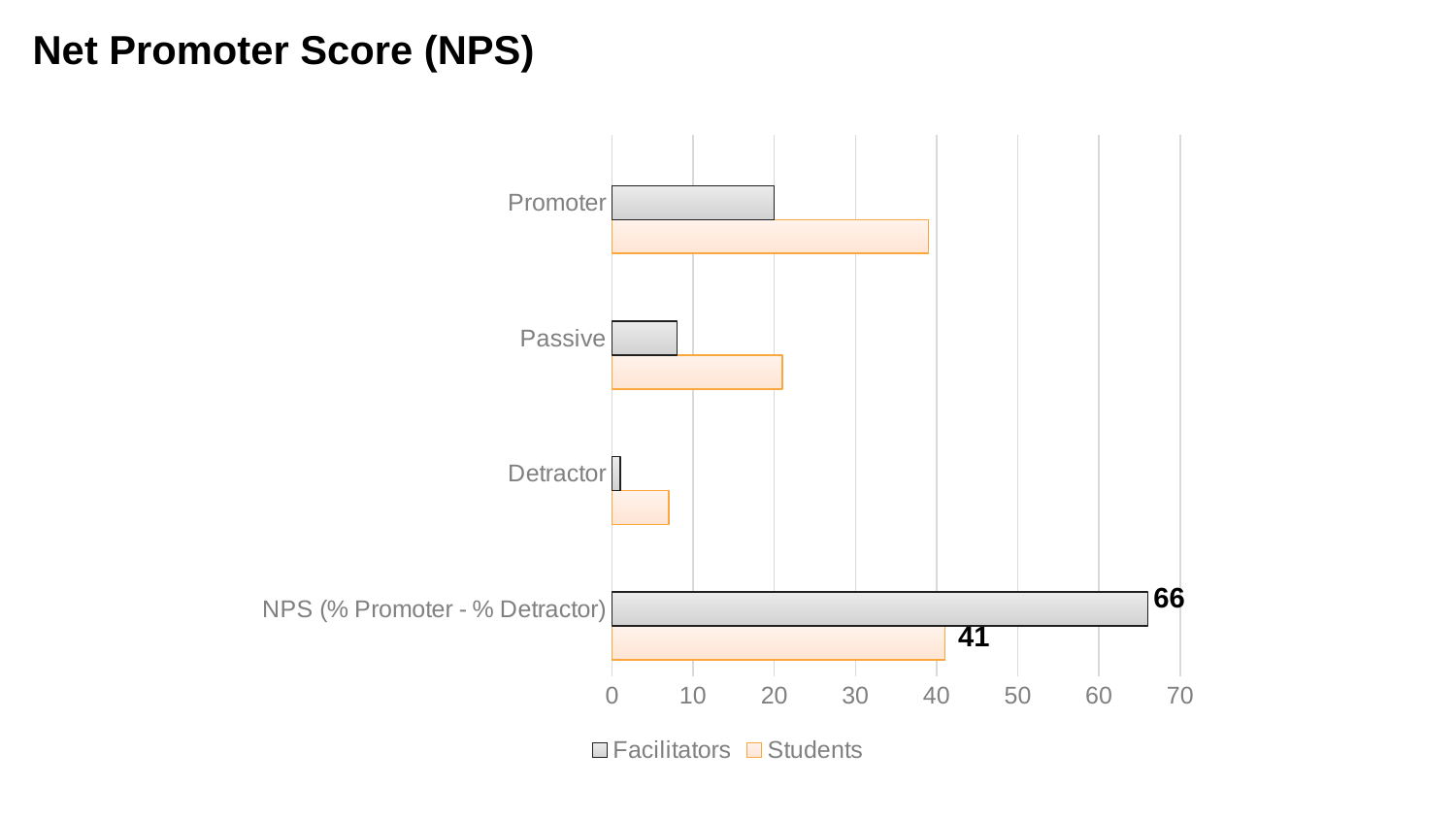
Is the Students value for Promoter greater or less than 30? greater How many categories are shown on the chart? 4 Is the Students value for Detractor greater or less than 10? less Which category has the highest value for the Students series? NPS (% Promoter - % Detractor) Is the Facilitators value for Passive greater or less than 10? less What kind of chart is shown on the slide? Bar chart What is the Facilitators value for NPS (% Promoter - % Detractor)? 66 How many series does the legend list? 2 Which category has the lowest value for the Facilitators series? Detractor What is the difference between the Facilitators and Students values for NPS (% Promoter - % Detractor)? 25 For NPS (% Promoter - % Detractor), which series has the larger value, Facilitators or Students? Facilitators What is the Students value for NPS (% Promoter - % Detractor)? 41